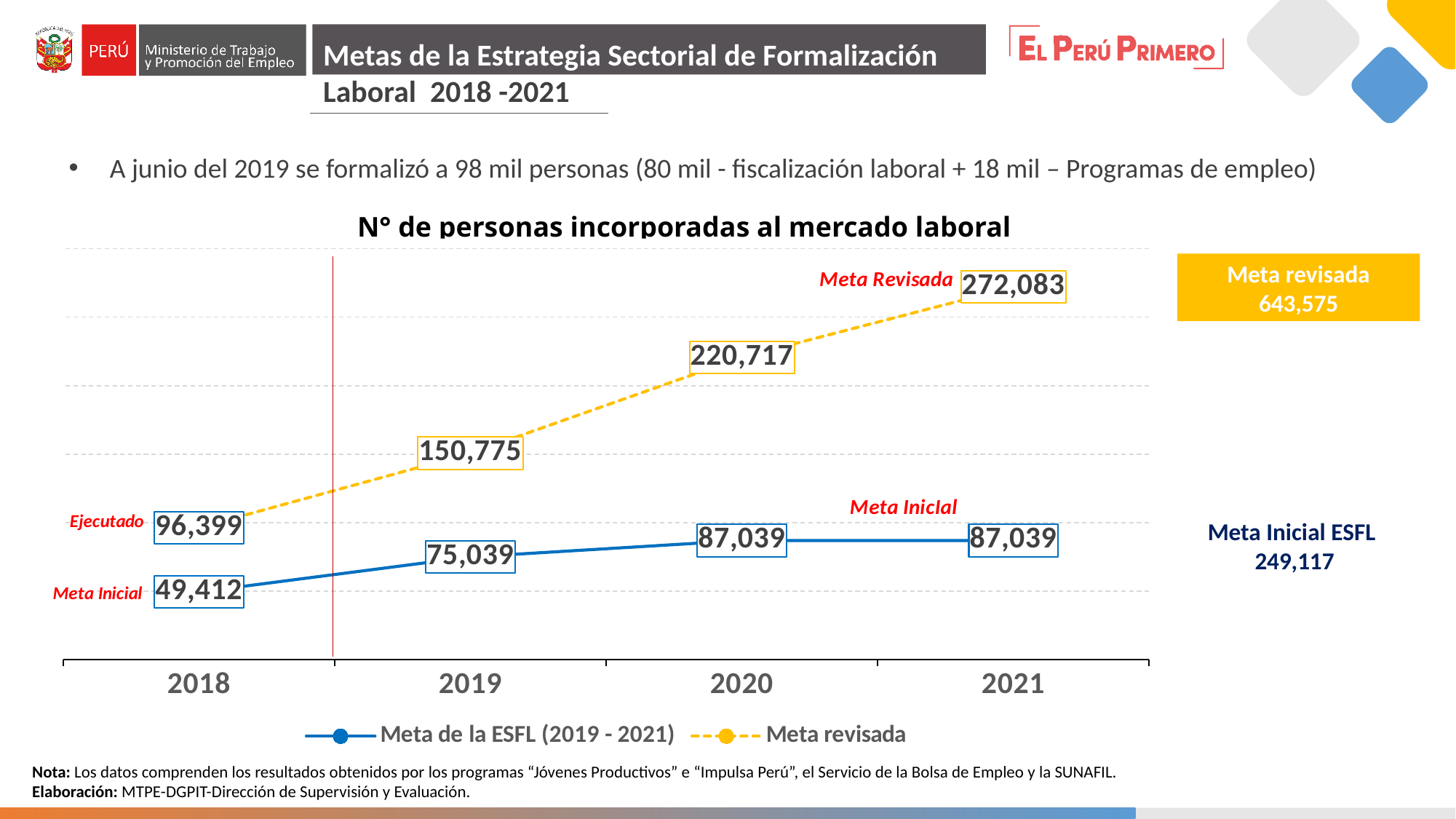
What is the title of the chart? N° de personas incorporadas al mercado laboral What type of chart is shown on the slide? line chart How many years are shown on the x axis of the chart? 4 How many series does the chart legend list? 2 What is the value of the Meta de la ESFL (2019 - 2021) series for 2019? 75,039 In which year does the Meta revisada series reach its highest value? 2021 What is the value of the Meta revisada series for 2018? 96,399 Which series has the larger value in 2019, Meta revisada or Meta de la ESFL (2019 - 2021)? Meta revisada What is the difference between the Meta revisada value and the Meta de la ESFL (2019 - 2021) value in 2020? 133,678 Does the Meta revisada series rise or fall from 2018 to 2021? rise What is the value of the Meta revisada series for 2021? 272,083 In which year does the Meta de la ESFL (2019 - 2021) series have its lowest value? 2018